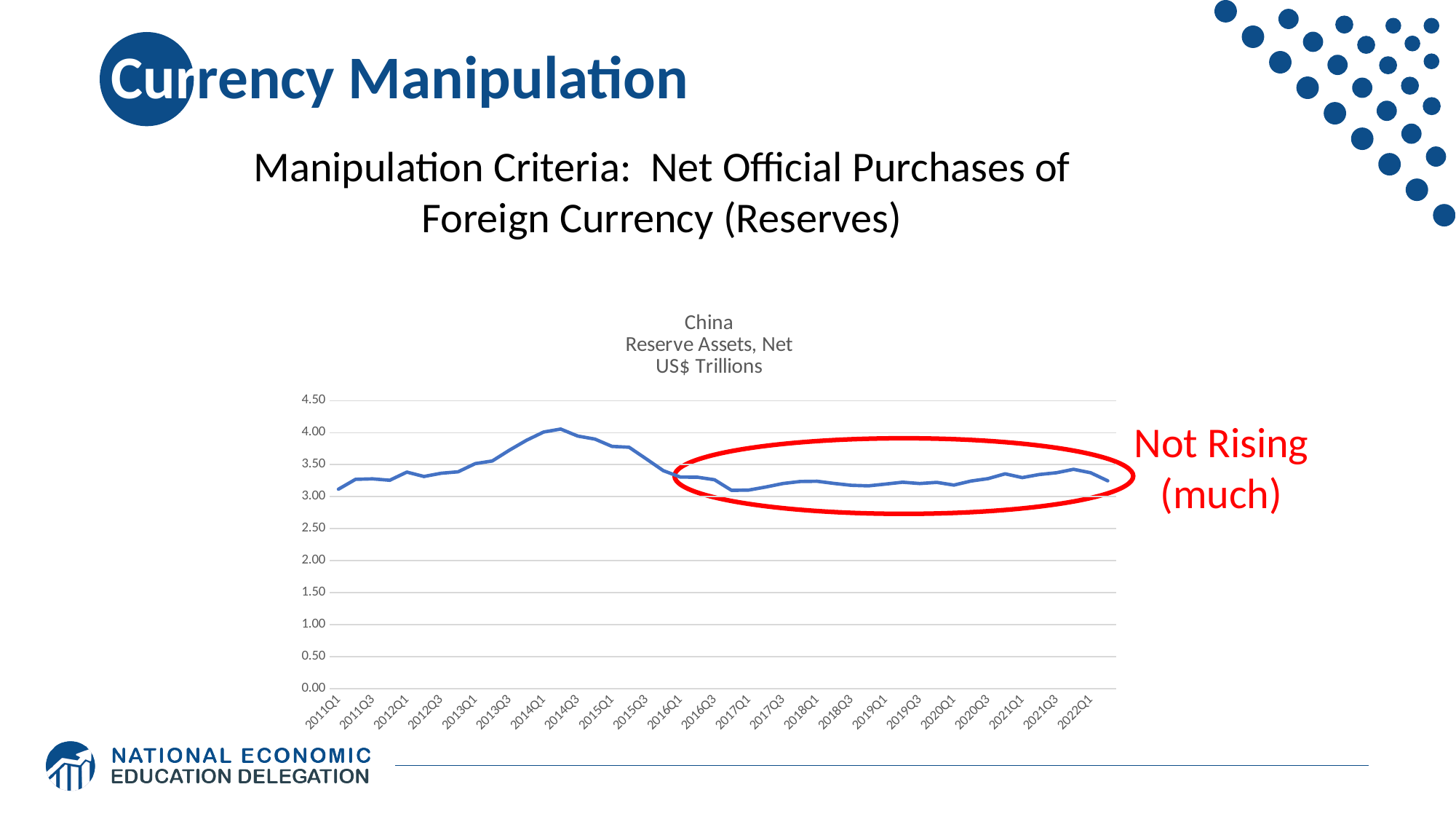
Is the value for 2017Q1 greater or less than 3.50? less Is the value for 2020Q1 greater or less than 3.50? less In which year does the line reach its highest value? 2014 Is the value for 2014Q3 greater or less than 3.50? greater What kind of chart is shown on the slide? line chart In what units are the values in the chart expressed, according to its title? US$ Trillions Does the line rise or fall between 2014Q3 and 2017Q1? fall Does the line rise or fall between 2011Q1 and 2014Q3? rise Which is larger, the value for 2014Q3 or the value for 2022Q1? 2014Q3 What does the red annotation next to the circled part of the line say? Not Rising (much)